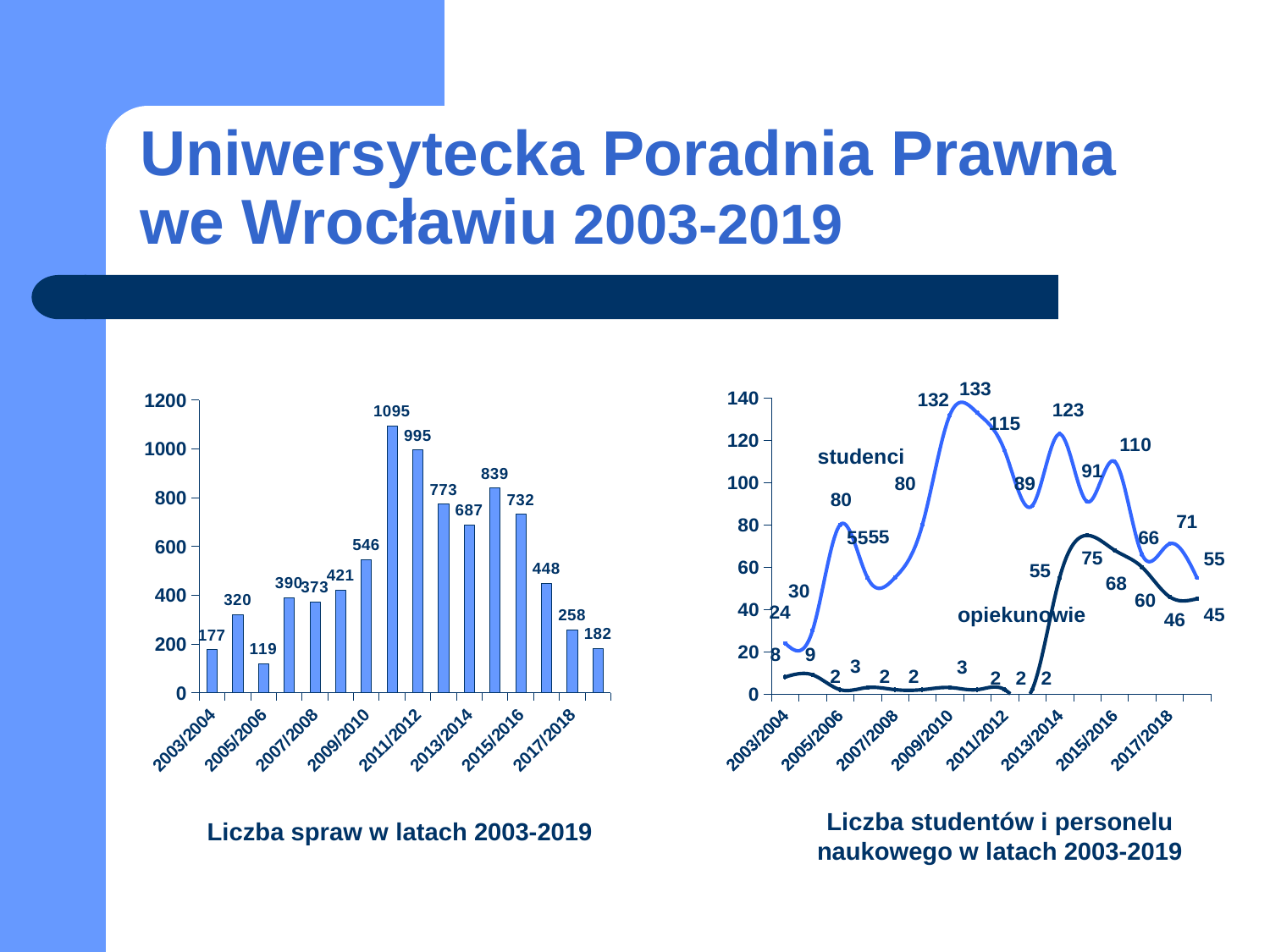
What are the names of the two series in the chart 'Liczba studentów i personelu naukowego w latach 2003-2019'? studenci and opiekunowie In the chart 'Liczba spraw w latach 2003-2019', what is the highest value shown? 1095 In the chart 'Liczba spraw w latach 2003-2019', what is the difference between the values for 2003/2004 and 2005/2006? 58 How many series are plotted in the chart 'Liczba studentów i personelu naukowego w latach 2003-2019'? 2 In the chart 'Liczba spraw w latach 2003-2019', what is the value for 2003/2004? 177 In the chart 'Liczba studentów i personelu naukowego w latach 2003-2019', what is the highest value for opiekunowie? 75 What kind of chart is 'Liczba spraw w latach 2003-2019'? bar chart In the chart 'Liczba spraw w latach 2003-2019', what is the lowest value shown? 119 In the chart 'Liczba spraw w latach 2003-2019', do the values rise or fall from 2015/2016 to the last bar? fall In the chart 'Liczba studentów i personelu naukowego w latach 2003-2019', which series has the larger value in 2003/2004, studenci or opiekunowie? studenci How many bars are plotted in the chart 'Liczba spraw w latach 2003-2019'? 16 In the chart 'Liczba studentów i personelu naukowego w latach 2003-2019', what is the highest value for studenci? 133